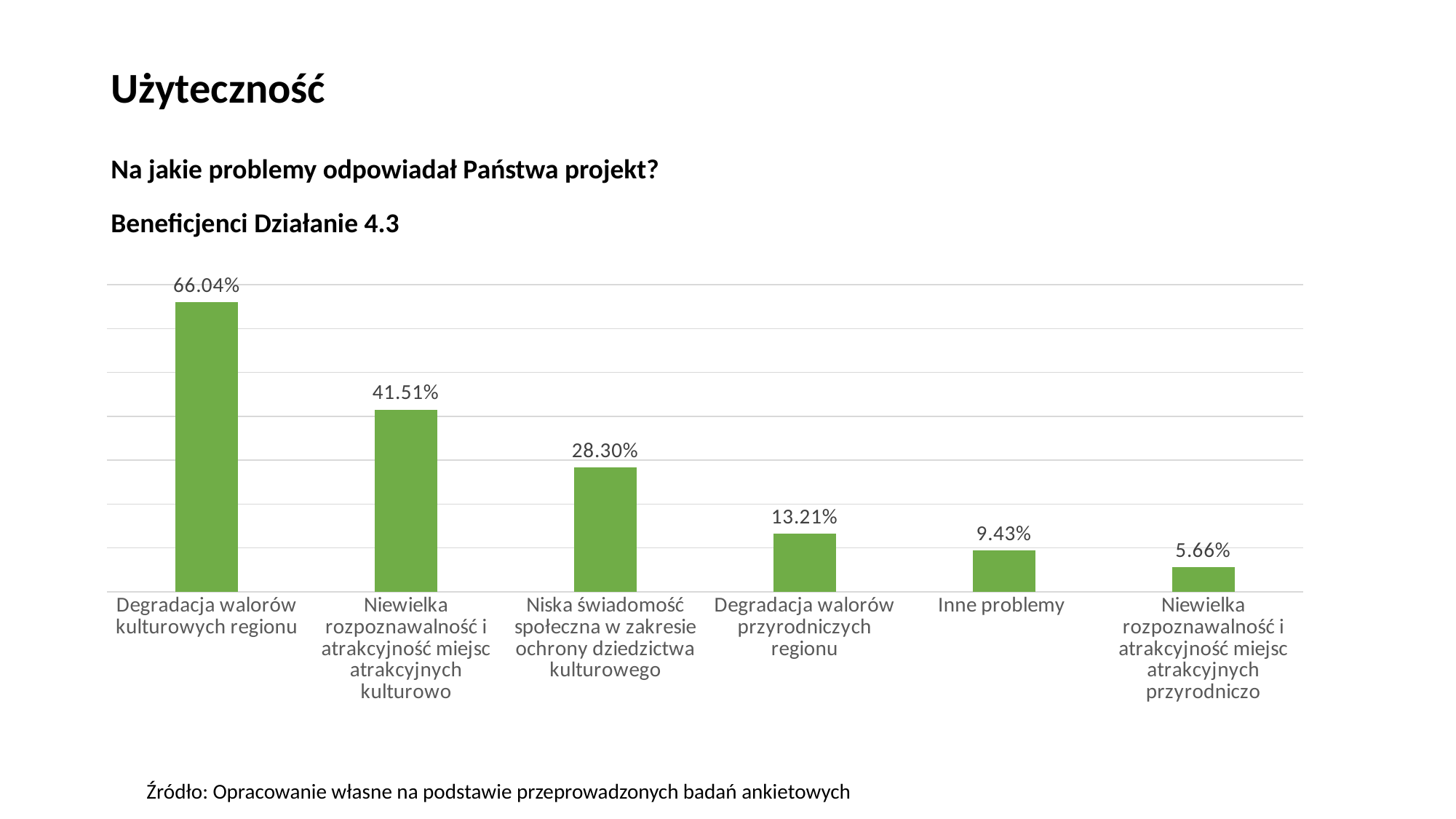
What percentage is shown for "Degradacja walorów kulturowych regionu"? 66.04% Which category has the highest value? Degradacja walorów kulturowych regionu What is the value for "Inne problemy"? 9.43% Do the values rise or fall from left to right across the categories? Fall What is the difference between the values for "Degradacja walorów kulturowych regionu" and "Niewielka rozpoznawalność i atrakcyjność miejsc atrakcyjnych kulturowo"? 24.53% What is the value for "Degradacja walorów przyrodniczych regionu"? 13.21% How many categories are shown in the chart? 6 What is the difference between "Niska świadomość społeczna w zakresie ochrony dziedzictwa kulturowego" and "Degradacja walorów przyrodniczych regionu"? 15.09% What kind of chart is shown on the slide? Bar chart What percentage is shown for "Niska świadomość społeczna w zakresie ochrony dziedzictwa kulturowego"? 28.30% Which category has the lowest value? Niewielka rozpoznawalność i atrakcyjność miejsc atrakcyjnych przyrodniczo Which is larger: the value for "Inne problemy" or for "Degradacja walorów przyrodniczych regionu"? Degradacja walorów przyrodniczych regionu